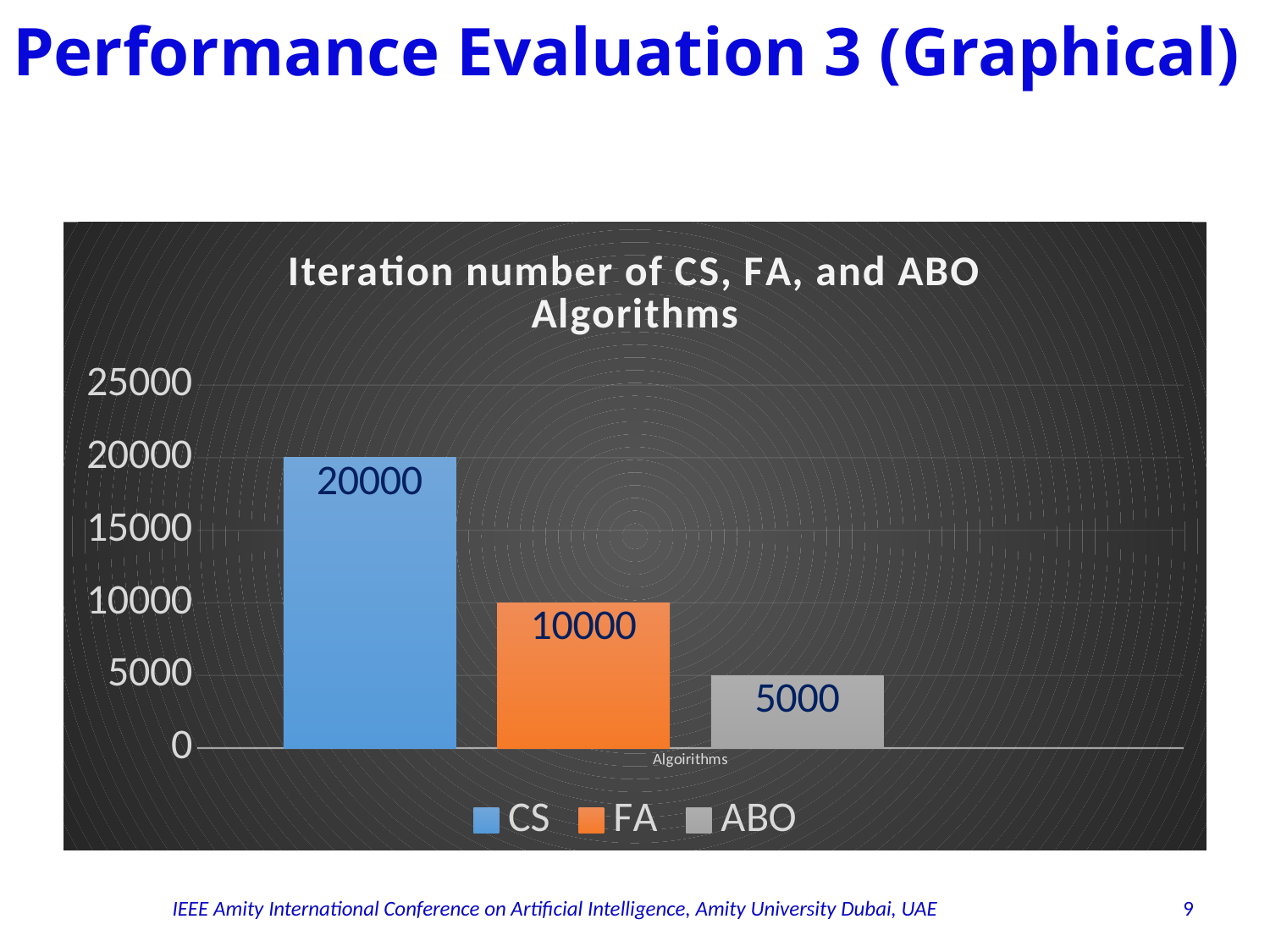
What is the title of the chart? Iteration number of CS, FA, and ABO Algorithms Which has a larger iteration number, FA or ABO? FA Is the iteration number for CS greater or less than 15000? greater Which algorithm has the highest iteration number? CS What is the iteration number for CS? 20000 What is the difference between the iteration numbers of CS and FA? 10000 What is the difference between the iteration numbers of FA and ABO? 5000 What is the iteration number for ABO? 5000 What kind of chart is shown on the slide? bar chart Which algorithm has the lowest iteration number? ABO How many series does the legend list? 3 What is the iteration number for FA? 10000